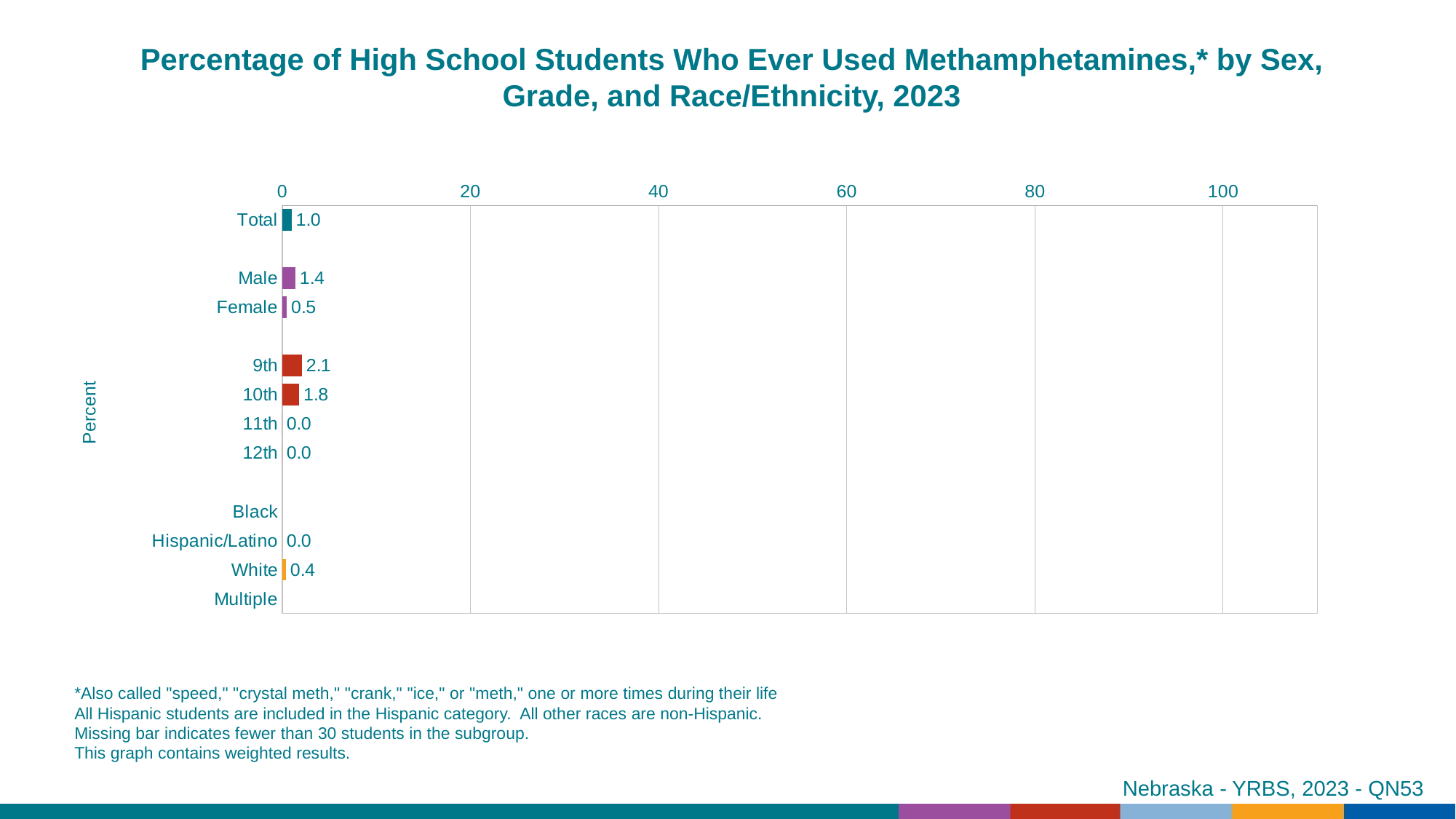
What is the title of the chart? Percentage of High School Students Who Ever Used Methamphetamines,* by Sex, Grade, and Race/Ethnicity, 2023 What is the value for White? 0.4 Is the value for 9th grade greater or less than 20? less Which is larger, the value for Male or the value for Female? Male What is the difference between the 9th and 10th grade values? 0.3 What is the value for Male? 1.4 What is the difference between the Male and Female values? 0.9 Which categories have no bar shown? Black and Multiple Which category has the highest value? 9th What kind of chart is shown on the slide? bar chart What is the value for 9th grade? 2.1 What is the value for Total? 1.0